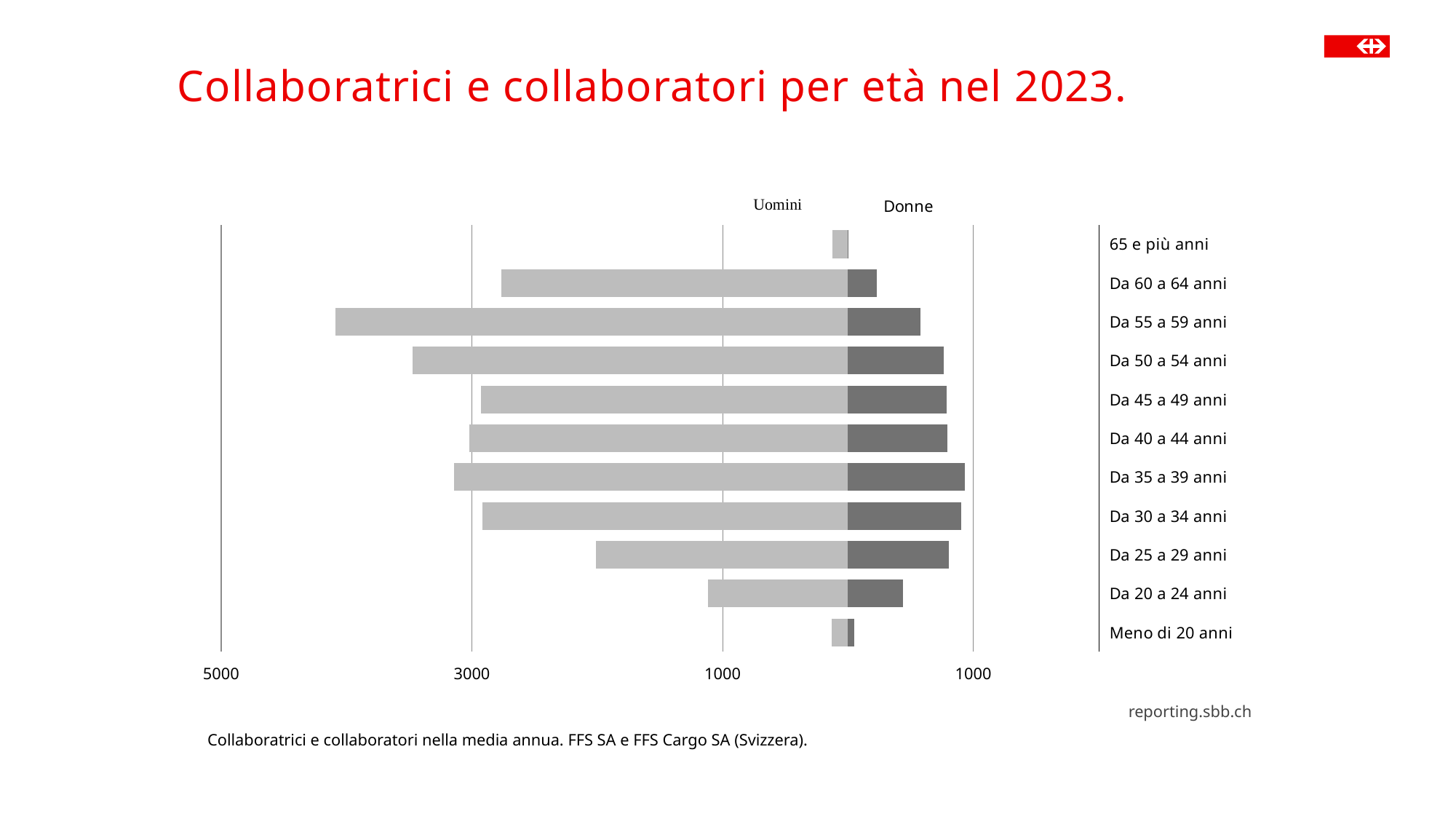
What is the title of the chart? Collaboratrici e collaboratori per età nel 2023. Is the Uomini value for Da 25 a 29 anni greater or less than 1000? greater Which is larger for Uomini: Da 55 a 59 anni or Da 50 a 54 anni? Da 55 a 59 anni Is the Uomini value for Da 60 a 64 anni greater or less than 3000? less Is the Donne value for Da 55 a 59 anni greater or less than 1000? less How many series does the chart show? 2 Which series is shown by the darker grey bars on the right side of the chart? Donne How many age categories are shown in the chart? 11 Which age category has the highest value for Uomini? Da 55 a 59 anni Which is larger for Donne: Da 20 a 24 anni or Da 60 a 64 anni? Da 20 a 24 anni What kind of chart is shown on the slide? bar chart